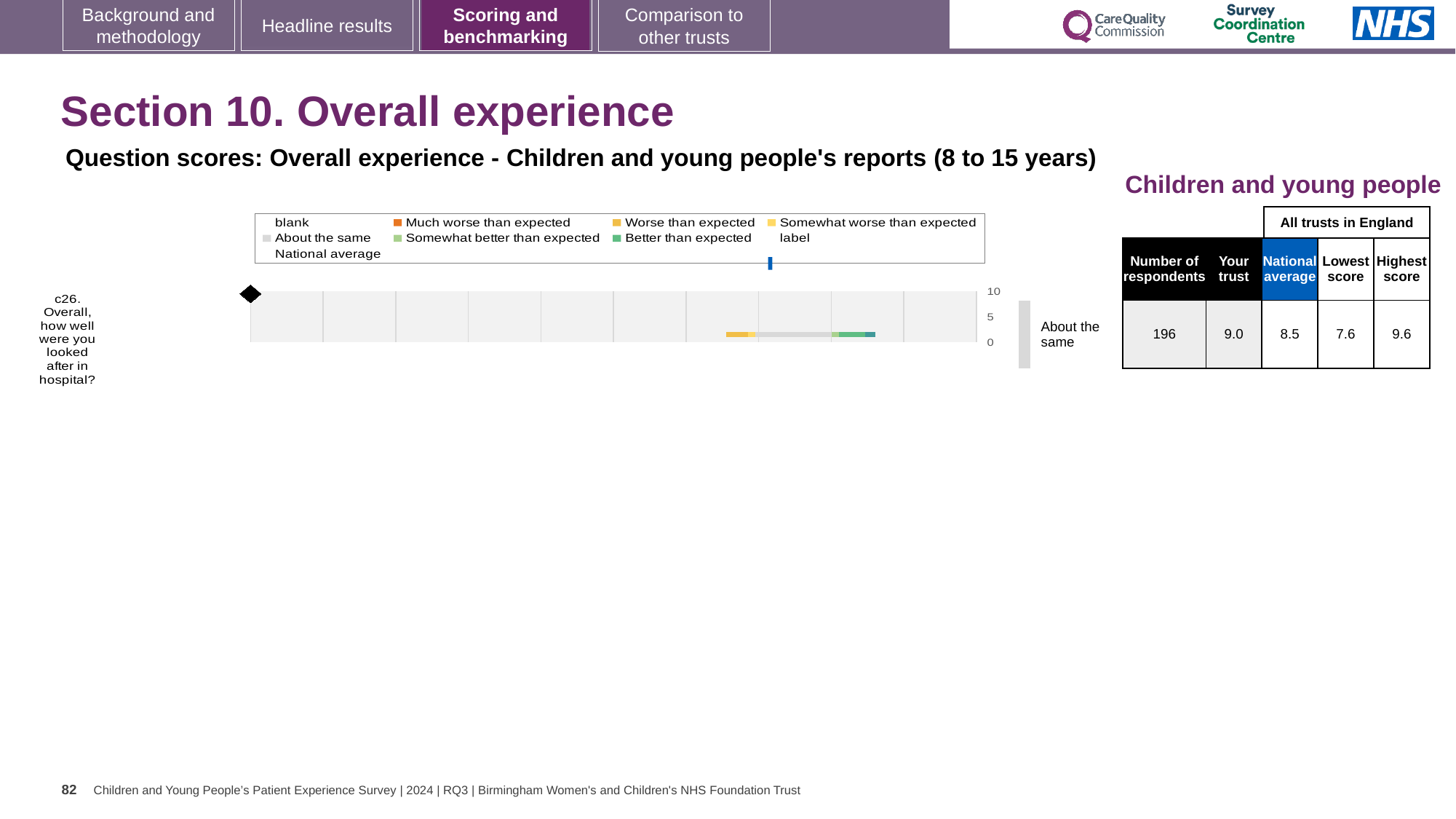
In the table next to the chart, what is the national average score for question c26? 8.5 What is the highest value shown on the chart's vertical axis? 10 What benchmark category label is shown to the right of the chart for question c26? About the same In the table next to the chart, what is the highest score among all trusts in England? 9.6 Which question is plotted on the chart? c26. Overall, how well were you looked after in hospital? How many questions (categories) are plotted on the chart? 1 How many entries does the chart legend list? 9 In the table next to the chart, how many respondents answered question c26? 196 In the table next to the chart, what is the 'Your trust' score for question c26? 9.0 What kind of chart is shown on the slide? bar chart In the table next to the chart, what is the lowest score among all trusts in England? 7.6 According to the table next to the chart, which is larger for question c26: the 'Your trust' score or the national average? Your trust